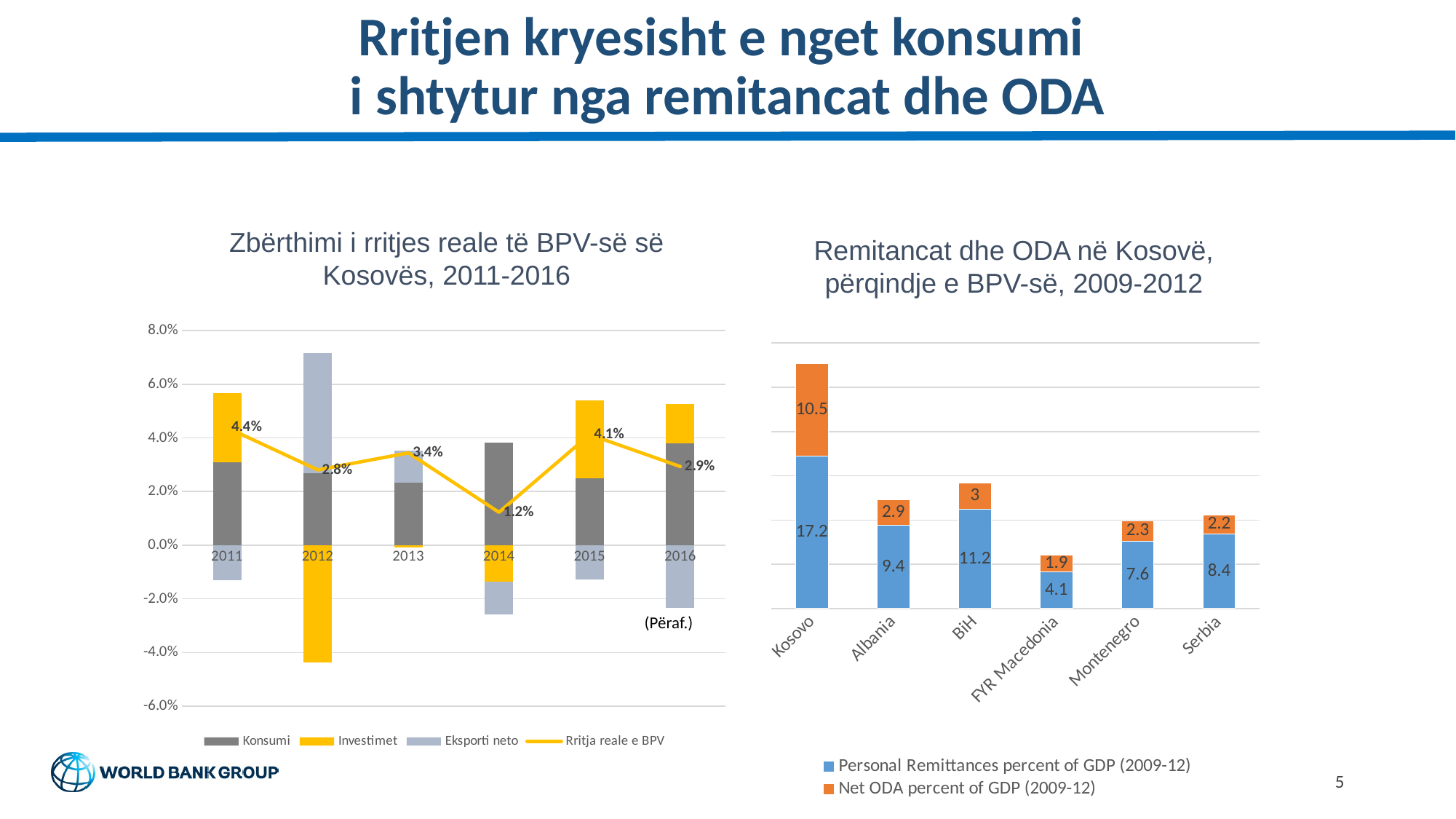
In the right chart (Remitancat dhe ODA në Kosovë), what is the total of the stacked bar for Albania? 12.3 In the left chart (Zbërthimi i rritjes reale të BPV-së së Kosovës), in which year is Rritja reale e BPV highest? 2011 In the right chart (Remitancat dhe ODA në Kosovë), which is larger: Personal Remittances percent of GDP for Serbia or for Montenegro? Serbia In the left chart (Zbërthimi i rritjes reale të BPV-së së Kosovës), what is the difference between Rritja reale e BPV in 2015 and 2014? 2.9% In the right chart (Remitancat dhe ODA në Kosovë), how many countries are shown? 6 In the left chart (Zbërthimi i rritjes reale të BPV-së së Kosovës), what is the value of Rritja reale e BPV for 2011? 4.4% In the left chart (Zbërthimi i rritjes reale të BPV-së së Kosovës), in which year is Rritja reale e BPV lowest? 2014 In the right chart (Remitancat dhe ODA në Kosovë), what is the Personal Remittances percent of GDP for Kosovo? 17.2 In the left chart (Zbërthimi i rritjes reale të BPV-së së Kosovës), how many series does the legend list? 4 In the right chart (Remitancat dhe ODA në Kosovë), which country has the lowest Personal Remittances percent of GDP? FYR Macedonia In the right chart (Remitancat dhe ODA në Kosovë), what is the Net ODA percent of GDP for BiH? 3 In the left chart (Zbërthimi i rritjes reale të BPV-së së Kosovës), is the Investimet value for 2012 greater or less than -4.0%? less